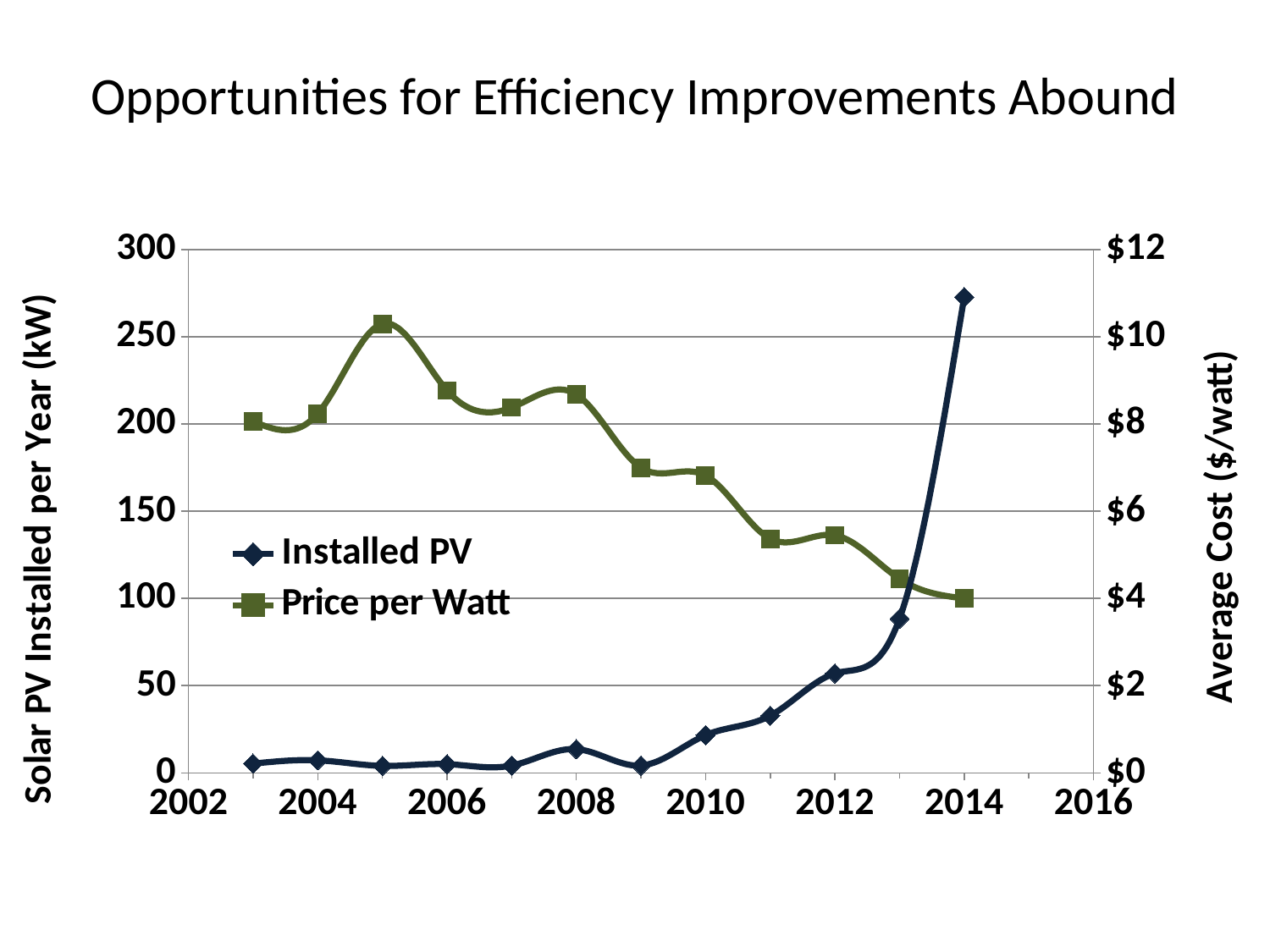
How many data points does the Installed PV series have? 12 In which year is Price per Watt highest? 2005 What kind of chart is shown on the slide? line chart Is the Installed PV value for 2014 greater or less than 250? greater Is the Price per Watt value for 2005 greater or less than $10? greater How many series does the legend list? 2 In which year is Price per Watt lowest? 2014 Is the Installed PV value for 2013 greater or less than 100? less In which year is Installed PV highest? 2014 What is the title of the left vertical axis? Solar PV Installed per Year (kW) Does Price per Watt rise or fall from 2008 to 2014? fall Which year has the higher Price per Watt, 2010 or 2011? 2010